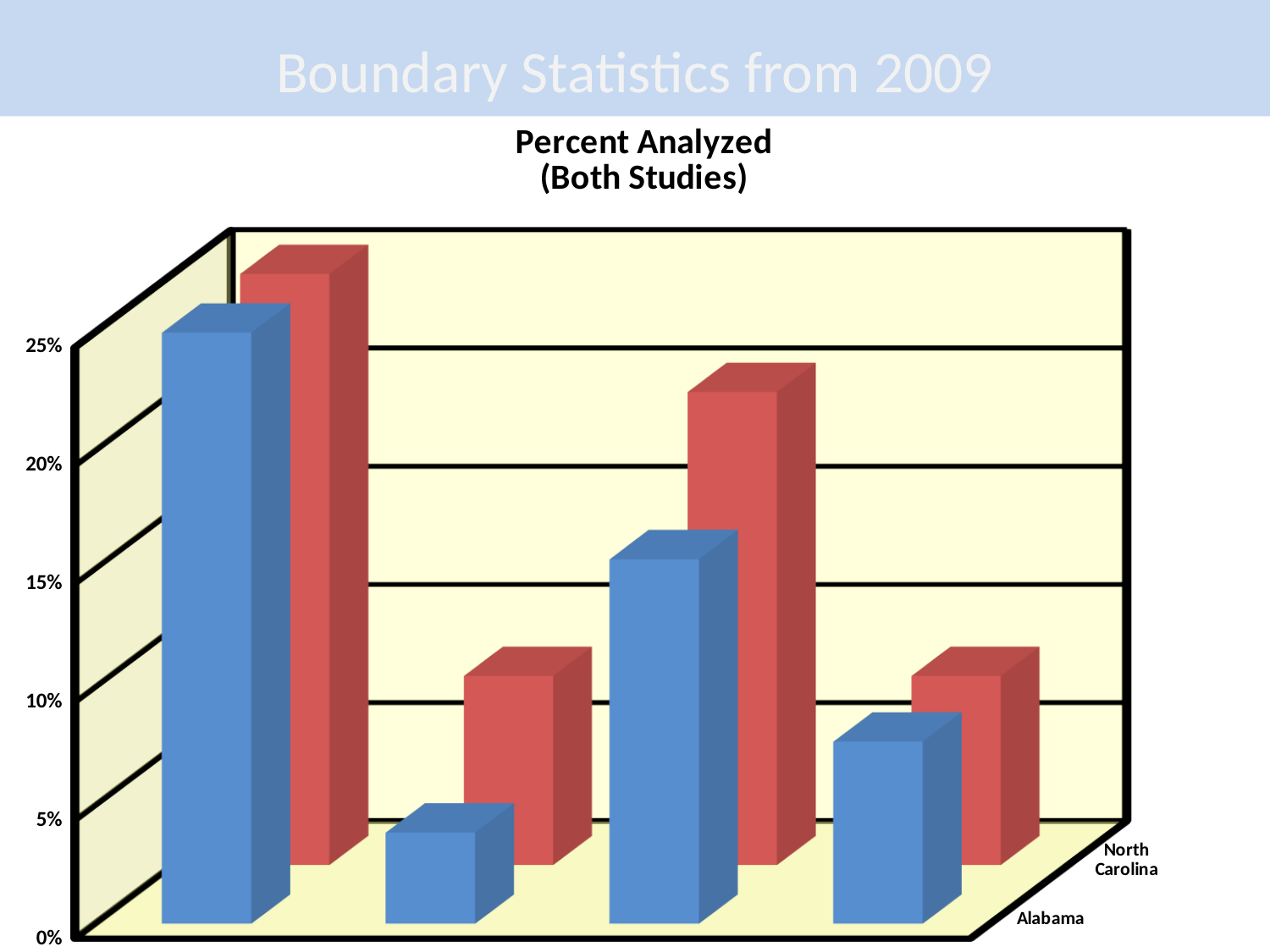
Which colour represents the North Carolina series? Red How many series does the chart show? 2 Which series has the shortest bar in the chart? Alabama Is the second Alabama bar from the left greater or less than 5%? less Is the rightmost Alabama bar greater or less than 10%? less What kind of chart is shown on the slide? Bar chart What is the title of the chart? Percent Analyzed (Both Studies) How many bars are plotted for the Alabama series? 4